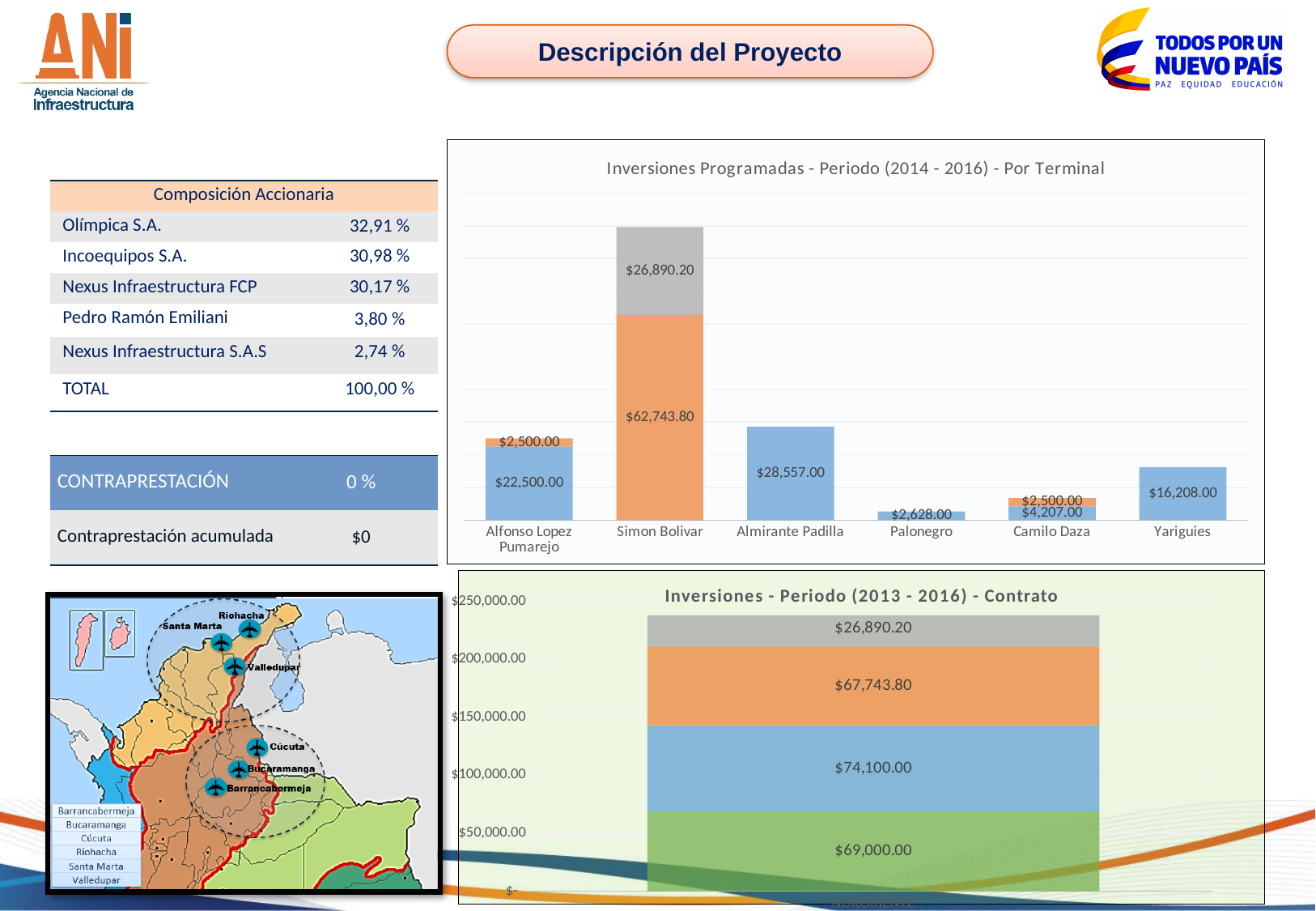
In the chart 'Inversiones - Periodo (2013 - 2016) - Contrato', what is the value of the bottom (green) segment of the bar? $69,000.00 In the chart 'Inversiones Programadas - Periodo (2014 - 2016) - Por Terminal', what is the total of the stacked bar for Simon Bolivar? $89,634.00 In the chart 'Inversiones Programadas - Periodo (2014 - 2016) - Por Terminal', what is the difference between the values for Almirante Padilla and Yariguies? $12,349.00 In the chart 'Inversiones - Periodo (2013 - 2016) - Contrato', what is the total of the stacked bar? $237,734.00 In the chart 'Inversiones Programadas - Periodo (2014 - 2016) - Por Terminal', which terminal has the highest total investment? Simon Bolivar In the chart 'Inversiones Programadas - Periodo (2014 - 2016) - Por Terminal', what is the total of the stacked bar for Alfonso Lopez Pumarejo? $25,000.00 In the chart 'Inversiones Programadas - Periodo (2014 - 2016) - Por Terminal', which has a larger total bar, Palonegro or Camilo Daza? Camilo Daza In the chart 'Inversiones Programadas - Periodo (2014 - 2016) - Por Terminal', how many terminals are shown on the x axis? 6 What kind of chart is 'Inversiones Programadas - Periodo (2014 - 2016) - Por Terminal'? Bar chart In the chart 'Inversiones Programadas - Periodo (2014 - 2016) - Por Terminal', what is the value for Almirante Padilla? $28,557.00 In the chart 'Inversiones Programadas - Periodo (2014 - 2016) - Por Terminal', what is the value for Yariguies? $16,208.00 In the chart 'Inversiones Programadas - Periodo (2014 - 2016) - Por Terminal', which terminal has the lowest total investment? Palonegro